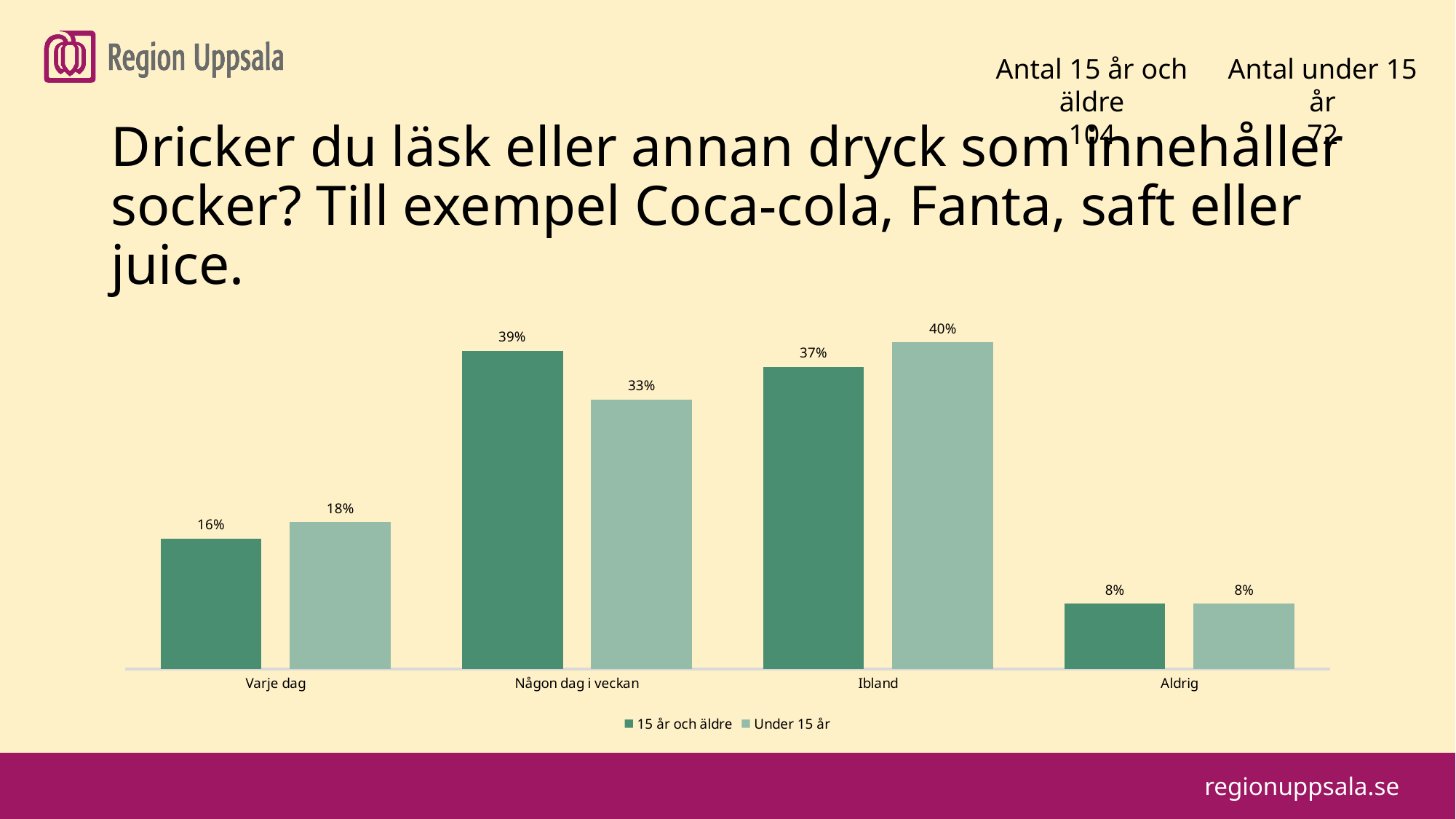
What is the value for "Under 15 år" in the "Varje dag" category? 18% What is the value for "Under 15 år" in the "Ibland" category? 40% Which category has the highest value for the "15 år och äldre" series? Någon dag i veckan What kind of chart is shown on the slide? Bar chart In the "Ibland" category, which series has the larger value, "15 år och äldre" or "Under 15 år"? Under 15 år What is the value for "15 år och äldre" in the "Någon dag i veckan" category? 39% How many categories are shown on the x axis of the chart? 4 What is the value for "15 år och äldre" in the "Aldrig" category? 8% Which category has the lowest value for the "Under 15 år" series? Aldrig How many series does the chart legend list? 2 Which series is shown in the darker green colour in the chart? 15 år och äldre What is the difference between the "15 år och äldre" and "Under 15 år" values in the "Någon dag i veckan" category? 6 percentage points